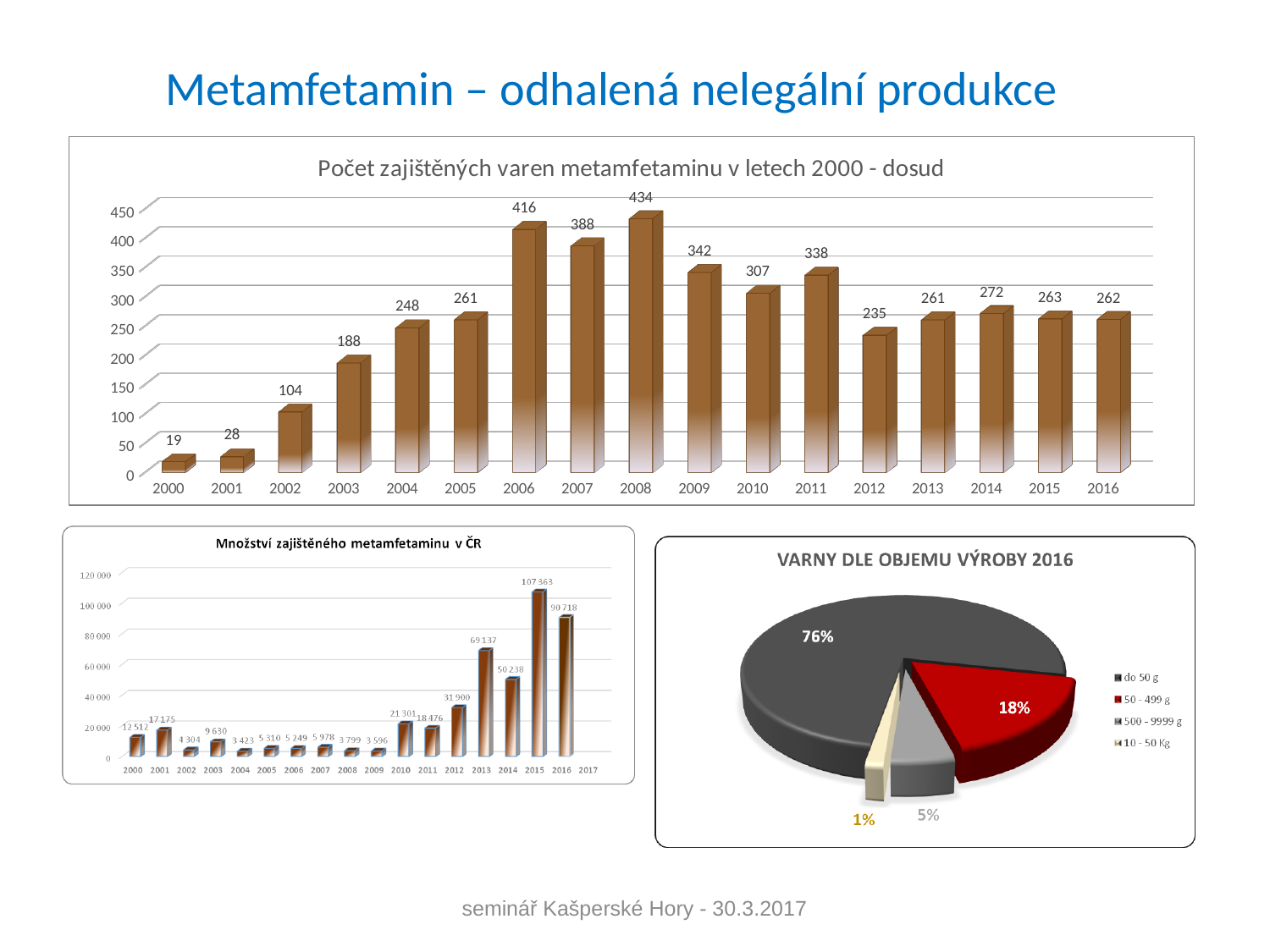
In the chart 'Počet zajištěných varen metamfetaminu v letech 2000 - dosud', which year has the lowest value? 2000 In the chart 'Množství zajištěného metamfetaminu v ČR', what is the value for 2015? 107 363 How many entries does the legend of the pie chart 'VARNY DLE OBJEMU VÝROBY 2016' list? 4 What kind of chart is 'Počet zajištěných varen metamfetaminu v letech 2000 - dosud'? Bar chart In the pie chart 'VARNY DLE OBJEMU VÝROBY 2016', what share does the 'do 50 g' slice have? 76% In the chart 'Počet zajištěných varen metamfetaminu v letech 2000 - dosud', what is the value for 2008? 434 In the chart 'Množství zajištěného metamfetaminu v ČR', which year has the highest value? 2015 In the chart 'Počet zajištěných varen metamfetaminu v letech 2000 - dosud', which year has the highest value? 2008 In the chart 'Počet zajištěných varen metamfetaminu v letech 2000 - dosud', which year has the larger value, 2012 or 2014? 2014 In the chart 'Počet zajištěných varen metamfetaminu v letech 2000 - dosud', do the values rise or fall from 2000 to 2006? Rise How many years are shown on the x axis of the chart 'Počet zajištěných varen metamfetaminu v letech 2000 - dosud'? 17 In the chart 'Počet zajištěných varen metamfetaminu v letech 2000 - dosud', what is the difference between the values for 2006 and 2007? 28